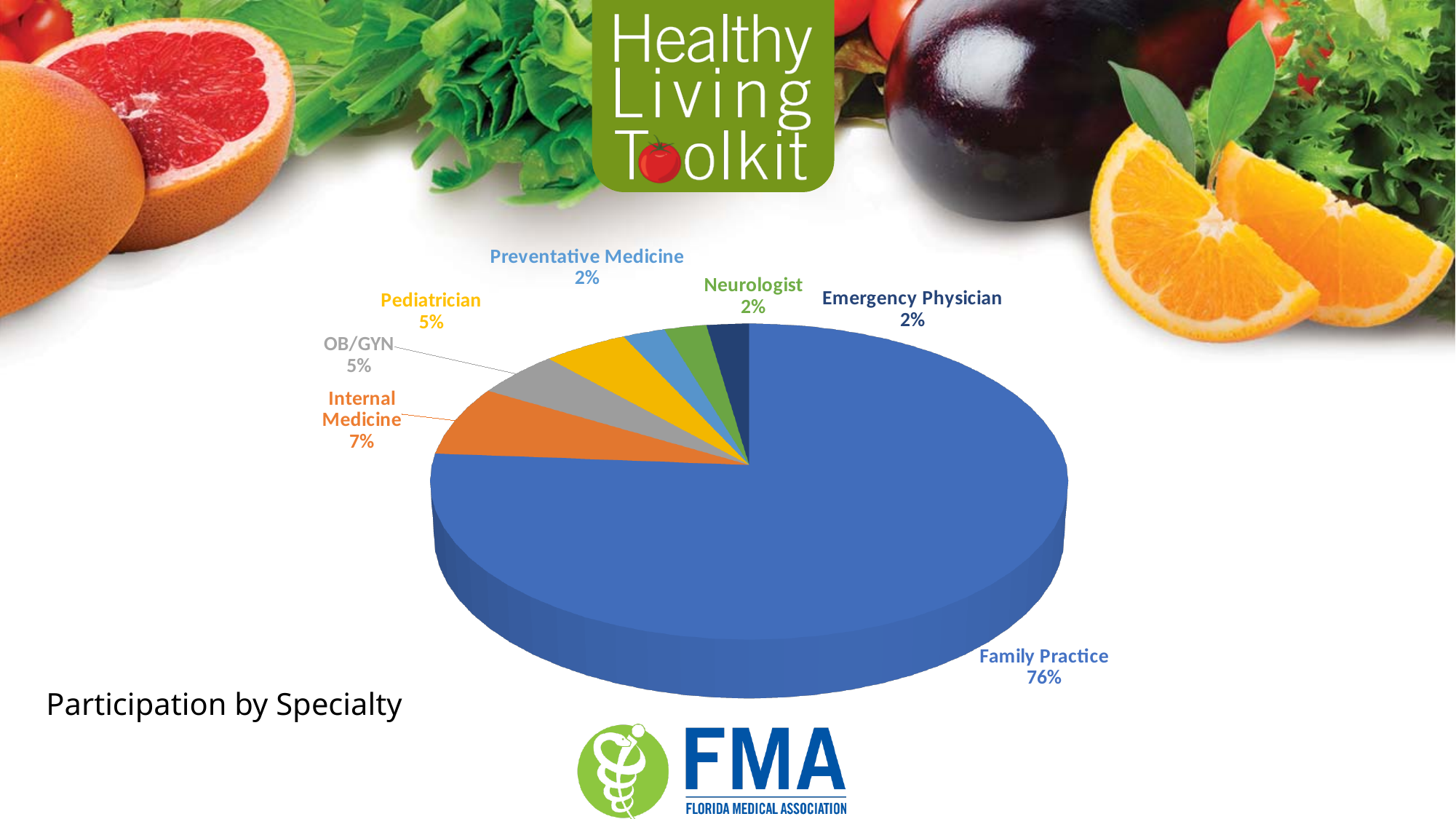
What is the value shown for Pediatrician? 5% Which has a larger share, Internal Medicine or Pediatrician? Internal Medicine What is the difference in percentage points between Family Practice and Internal Medicine? 69 What is the title of the chart on the slide? Participation by Specialty Which specialty has the largest share of participation? Family Practice What share does Neurologist have in the pie chart? 2% What percentage of participation is Internal Medicine? 7% What share of participation does Family Practice account for? 76% What type of chart is shown on the slide? Pie chart How many specialties are shown in the pie chart? 7 What percentage is shown for OB/GYN? 5% What is the combined share of Preventative Medicine, Neurologist and Emergency Physician? 6%